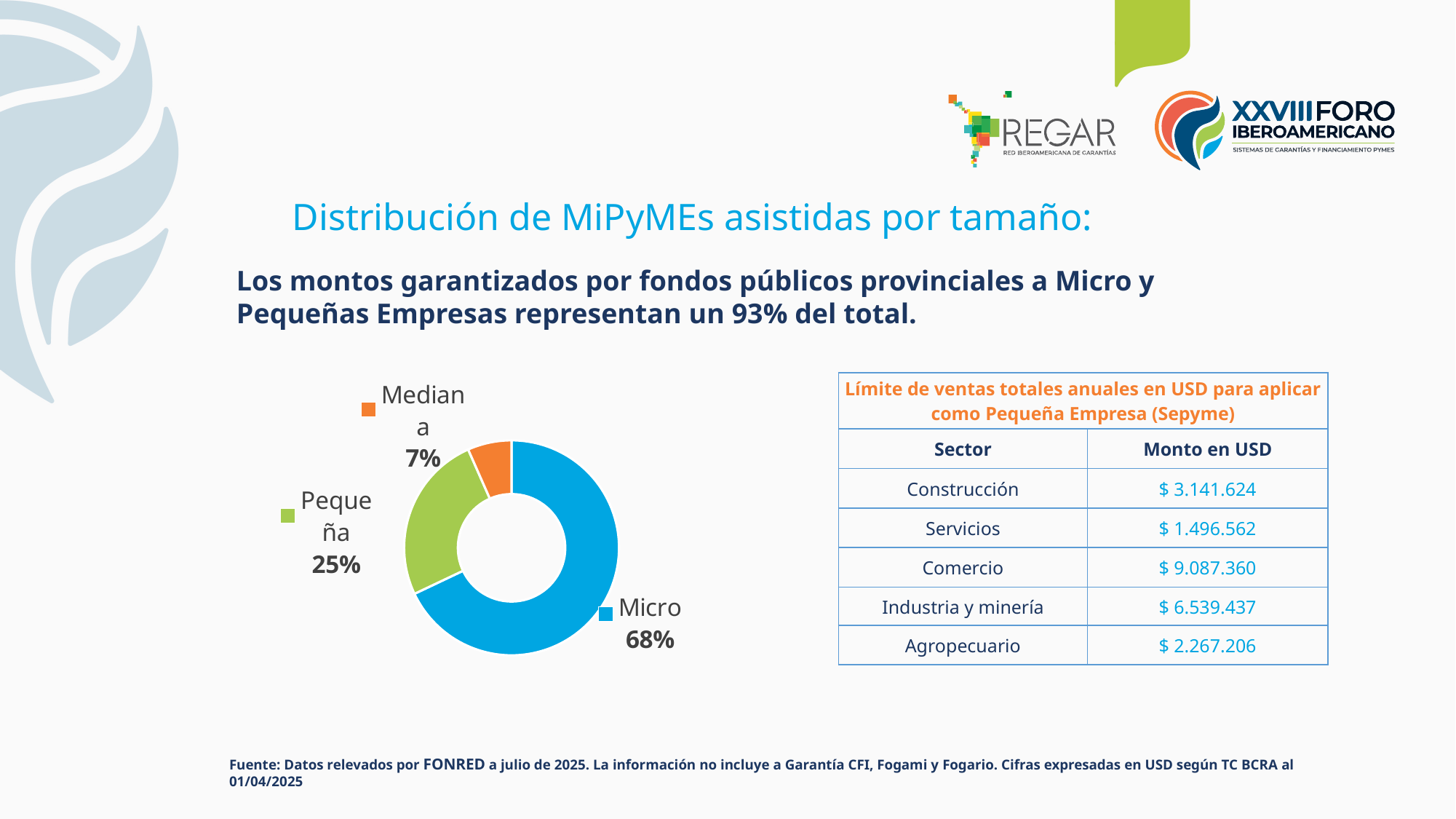
What share of the pie chart does Pequeña represent? 25% Which slice is larger, Pequeña or Mediana? Pequeña What kind of chart is shown on the slide? Pie chart (donut) What is the difference in percentage points between the Micro and Pequeña slices? 43 What is the combined share of the Micro and Pequeña slices? 93% How many categories are shown in the pie chart? 3 Which category has the smallest slice in the pie chart? Mediana What is the difference in percentage points between the Pequeña and Mediana slices? 18 What share of the pie chart does Mediana represent? 7% What colour is the Micro slice in the pie chart? Blue Which category has the largest slice in the pie chart? Micro What share of the pie chart does Micro represent? 68%